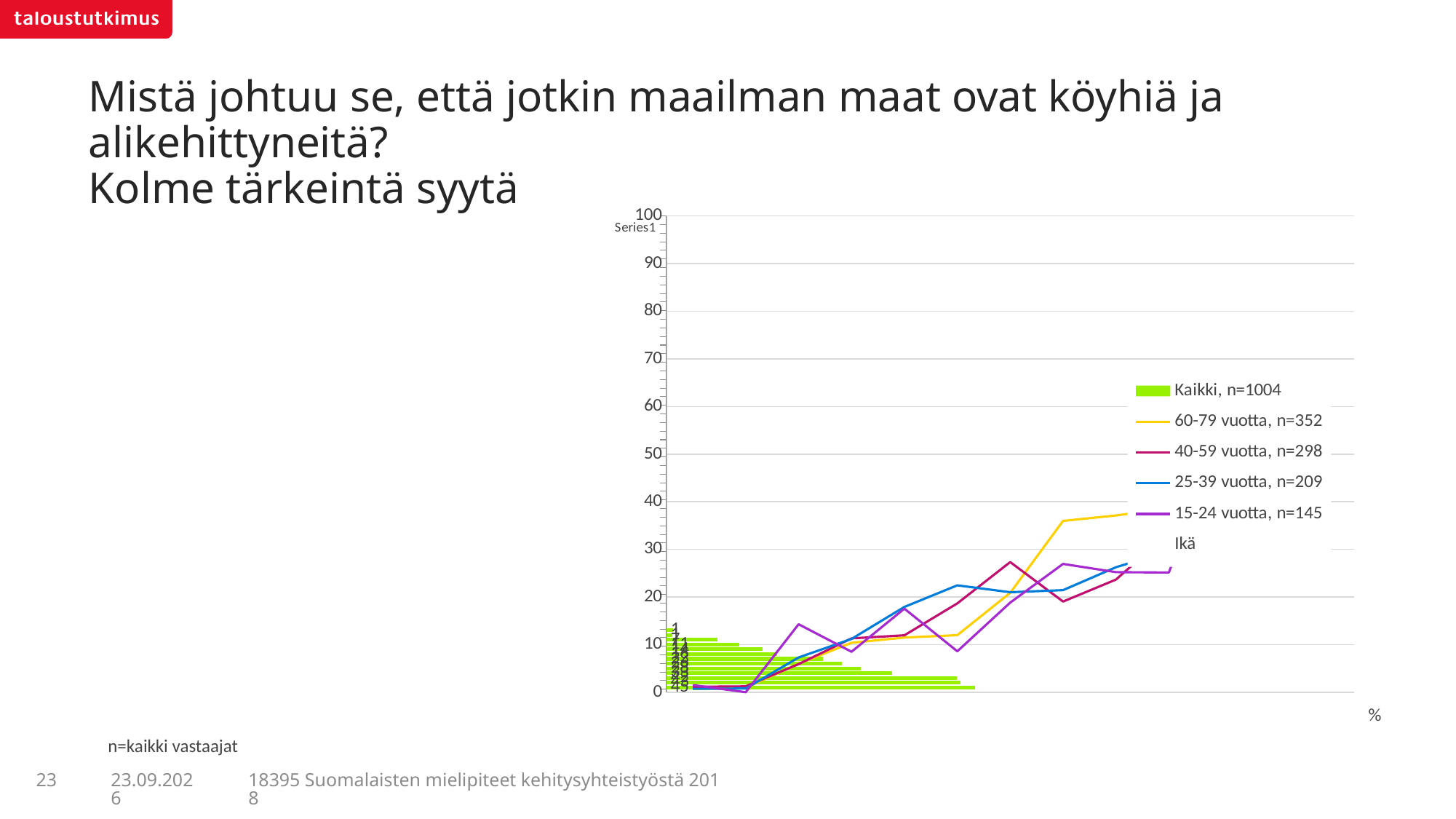
What is the highest value shown on the vertical axis? 100 What is the sample size (n) given in the legend for the 60-79 vuotta group? n=352 What colour are the bars for the 'Kaikki, n=1004' series? Green What is the sample size (n) given in the legend for the 15-24 vuotta group? n=145 How many series does the legend list? 6 What kind of chart is shown on the slide? A combination of a bar chart and a line chart Which age group in the legend has the smallest sample size? 15-24 vuotta, n=145 Which age group in the legend has the largest sample size? 60-79 vuotta, n=352